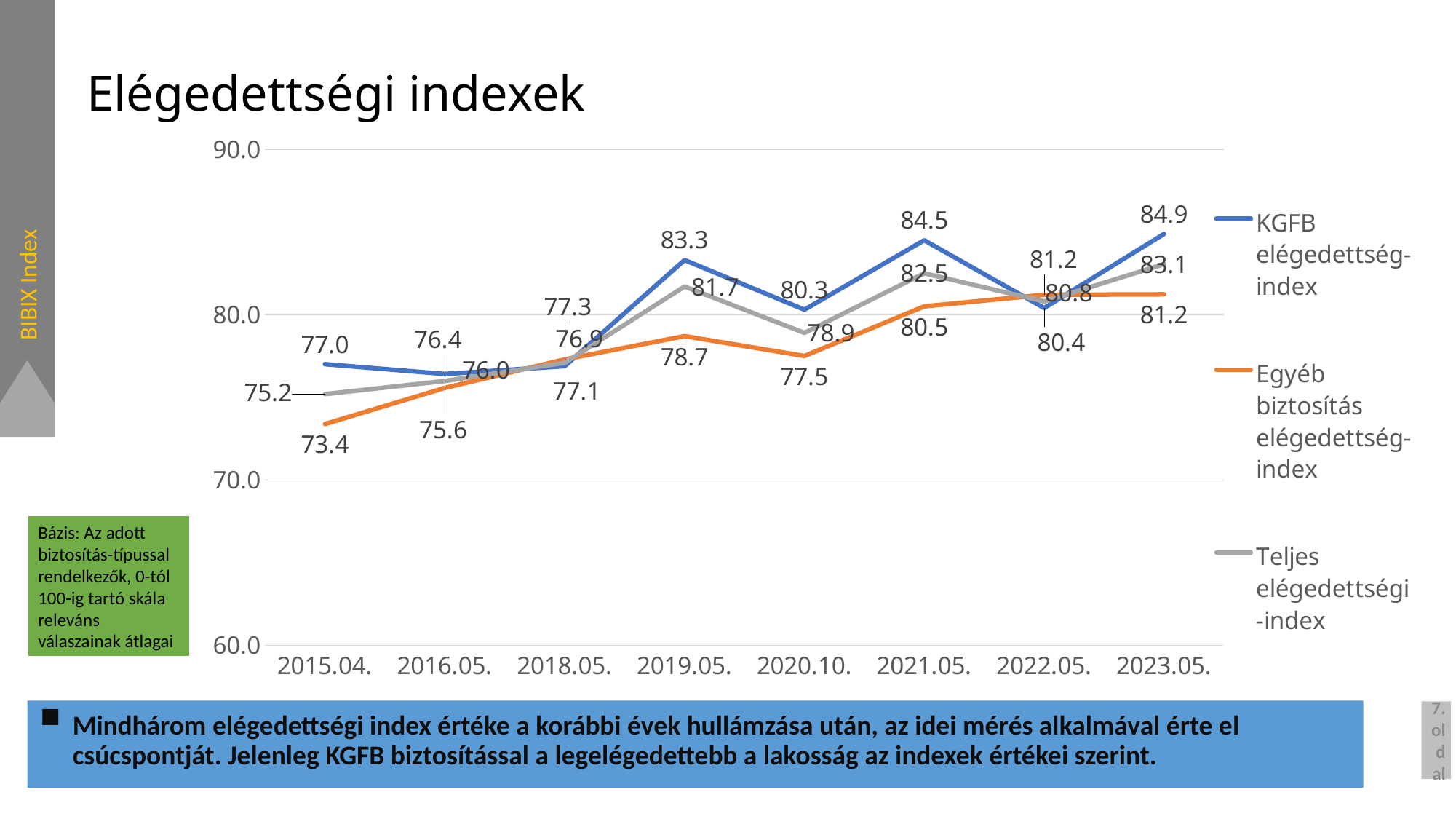
What is the value of the Teljes elégedettségi-index in 2021.05.? 82.5 What is the value of the KGFB elégedettség-index in 2023.05.? 84.9 In which year is the Egyéb biztosítás elégedettség-index at its lowest? 2015.04. What type of chart is shown on the slide? line chart What is the difference between the KGFB elégedettség-index and the Egyéb biztosítás elégedettség-index in 2023.05.? 3.7 What colour is the line for the Teljes elégedettségi-index? gray In which year does the KGFB elégedettség-index reach its highest value? 2023.05. How many time points are shown on the x axis? 8 How many series does the legend list? 3 Does the Egyéb biztosítás elégedettség-index generally rise or fall from 2015.04. to 2023.05.? rise What is the value of the Egyéb biztosítás elégedettség-index in 2015.04.? 73.4 Which is larger in 2022.05.: the KGFB elégedettség-index or the Egyéb biztosítás elégedettség-index? Egyéb biztosítás elégedettség-index